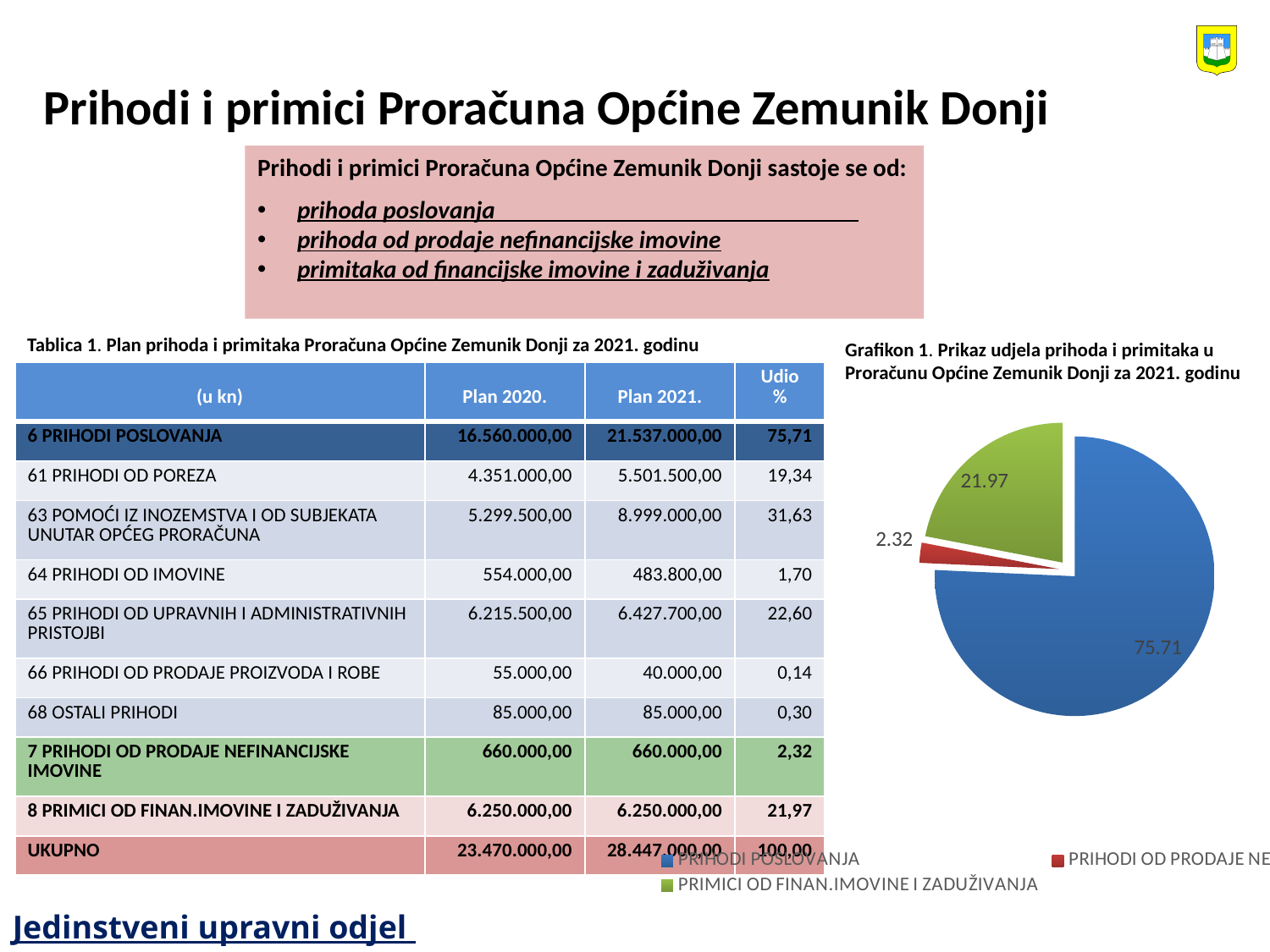
What kind of chart is Grafikon 1 on the slide? pie chart What value is shown on the red slice of the pie chart? 2.32 What value is shown on the pie chart for PRIHODI POSLOVANJA? 75.71 How many entries does the pie chart's legend list? 3 What value is shown on the pie chart for PRIMICI OD FINAN.IMOVINE I ZADUŽIVANJA? 21.97 Which category has the largest slice in the pie chart? PRIHODI POSLOVANJA In the pie chart, what is the difference between the value for PRIHODI POSLOVANJA and the value for PRIMICI OD FINAN.IMOVINE I ZADUŽIVANJA? 53.74 What colour is the PRIHODI POSLOVANJA slice in the pie chart? blue What is the title of the pie chart on the slide? Grafikon 1. Prikaz udjela prihoda i primitaka u Proračunu Općine Zemunik Donji za 2021. godinu How many slices does the pie chart have? 3 What value is shown on the smallest slice of the pie chart? 2.32 In the pie chart, which is larger: PRIMICI OD FINAN.IMOVINE I ZADUŽIVANJA or PRIHODI POSLOVANJA? PRIHODI POSLOVANJA